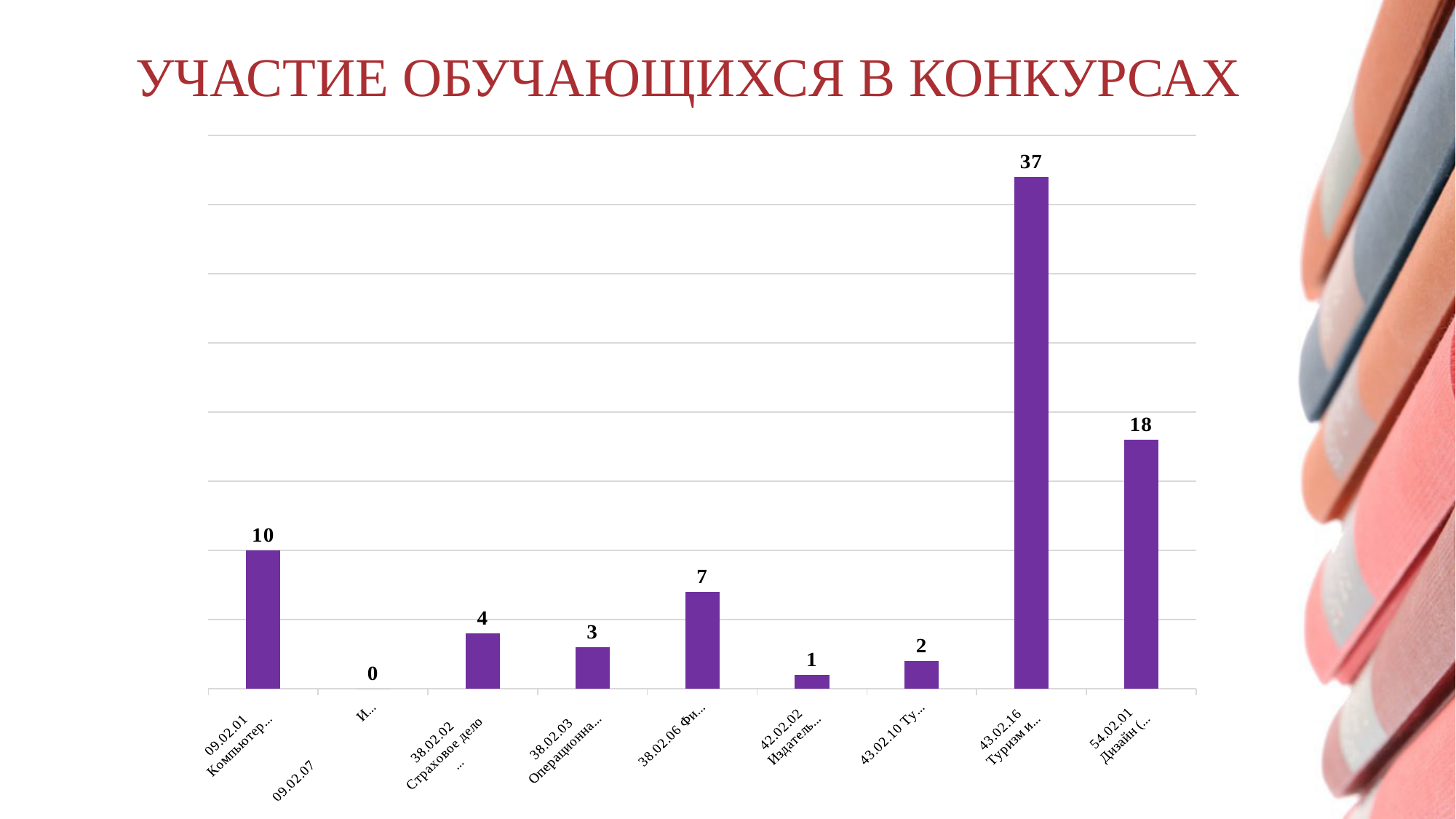
What is the value for 38.02.06? 7 What type of chart is shown on the slide? bar chart What is the difference between the values for 43.02.16 and 54.02.01? 19 Which category has the lowest value? 09.02.07 What is the value for 43.02.16 (Туризм и...)? 37 What is the value for 09.02.01 (Компьютер...)? 10 Which category has the highest value? 43.02.16 (Туризм и...) How many categories are shown on the x axis? 9 Which is larger, the value for 38.02.02 (Страховое дело) or the value for 38.02.03 (Операционна...)? 38.02.02 (Страховое дело) What is the title of the slide? УЧАСТИЕ ОБУЧАЮЩИХСЯ В КОНКУРСАХ What is the value for 09.02.07? 0 What is the value for 54.02.01 (Дизайн)? 18